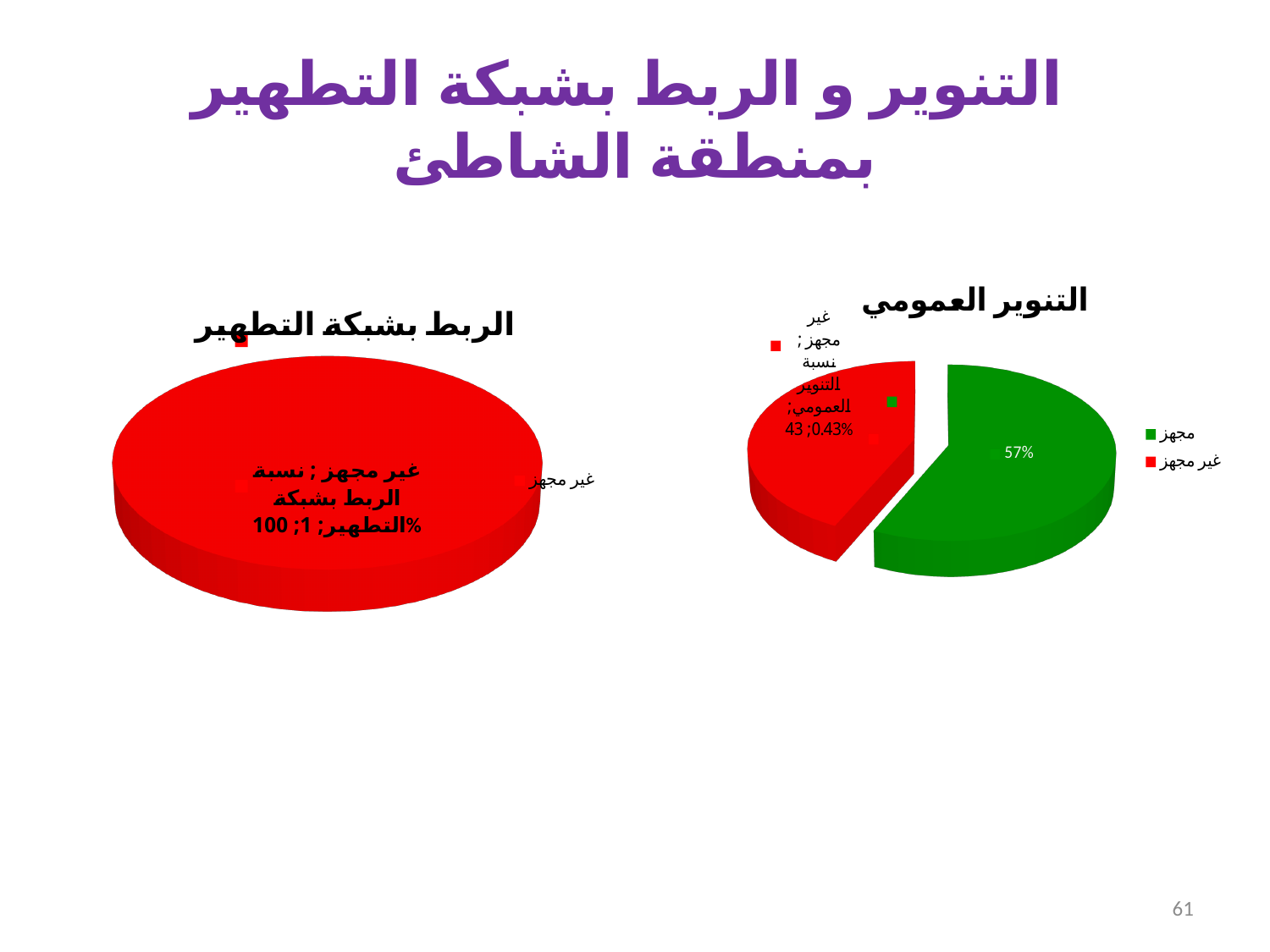
What type of chart is the chart titled "الربط بشبكة التطهير"? Pie chart In the chart titled "التنوير العمومي", what percentage is shown for the "غير مجهز" slice? 43% In the chart titled "الربط بشبكة التطهير", how many slices are shown in the pie? 1 In the chart titled "التنوير العمومي", how many entries does the legend list? 2 In the chart titled "التنوير العمومي", what percentage is shown for the "مجهز" slice? 57% In the chart titled "الربط بشبكة التطهير", what percentage is shown for the "غير مجهز" slice? 100% How many charts are shown on the slide? 2 In the chart titled "التنوير العمومي", what colour is the "مجهز" slice? Green In the chart titled "التنوير العمومي", which slice is the smallest? غير مجهز In the chart titled "التنوير العمومي", which slice is the largest? مجهز In the chart titled "التنوير العمومي", which is larger: "مجهز" or "غير مجهز"? مجهز In the chart titled "التنوير العمومي", what is the difference in percentage points between the "مجهز" and "غير مجهز" slices? 14